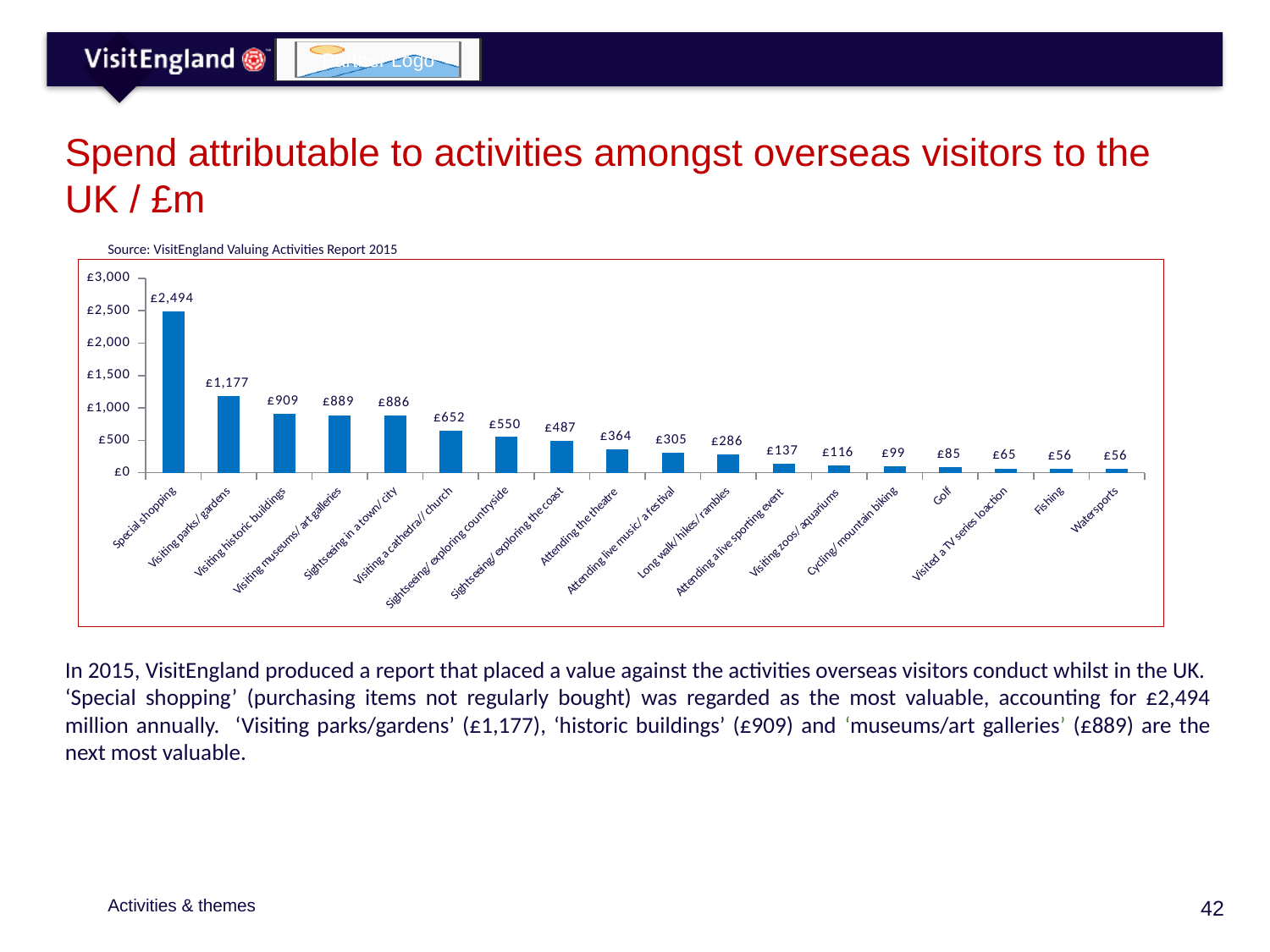
How many activities are shown on the chart? 18 Is the value for Sightseeing/exploring the coast greater or less than £500? less What is the spend attributable to Visiting a cathedral/church? £652 What is the difference in spend between Special shopping and Visiting parks/gardens? £1,317 What is the spend attributable to Golf? £85 Which activity has the highest spend attributable to it? Special shopping What is the spend attributable to Attending a live sporting event? £137 Which has a higher spend: Attending the theatre or Long walk/hikes/rambles? Attending the theatre What type of chart is shown on the slide? Bar chart What is the difference in spend between Visiting historic buildings and Visiting museums/art galleries? £20 What is the spend attributable to Special shopping? £2,494 Do the values rise or fall moving from left to right along the x axis? Fall